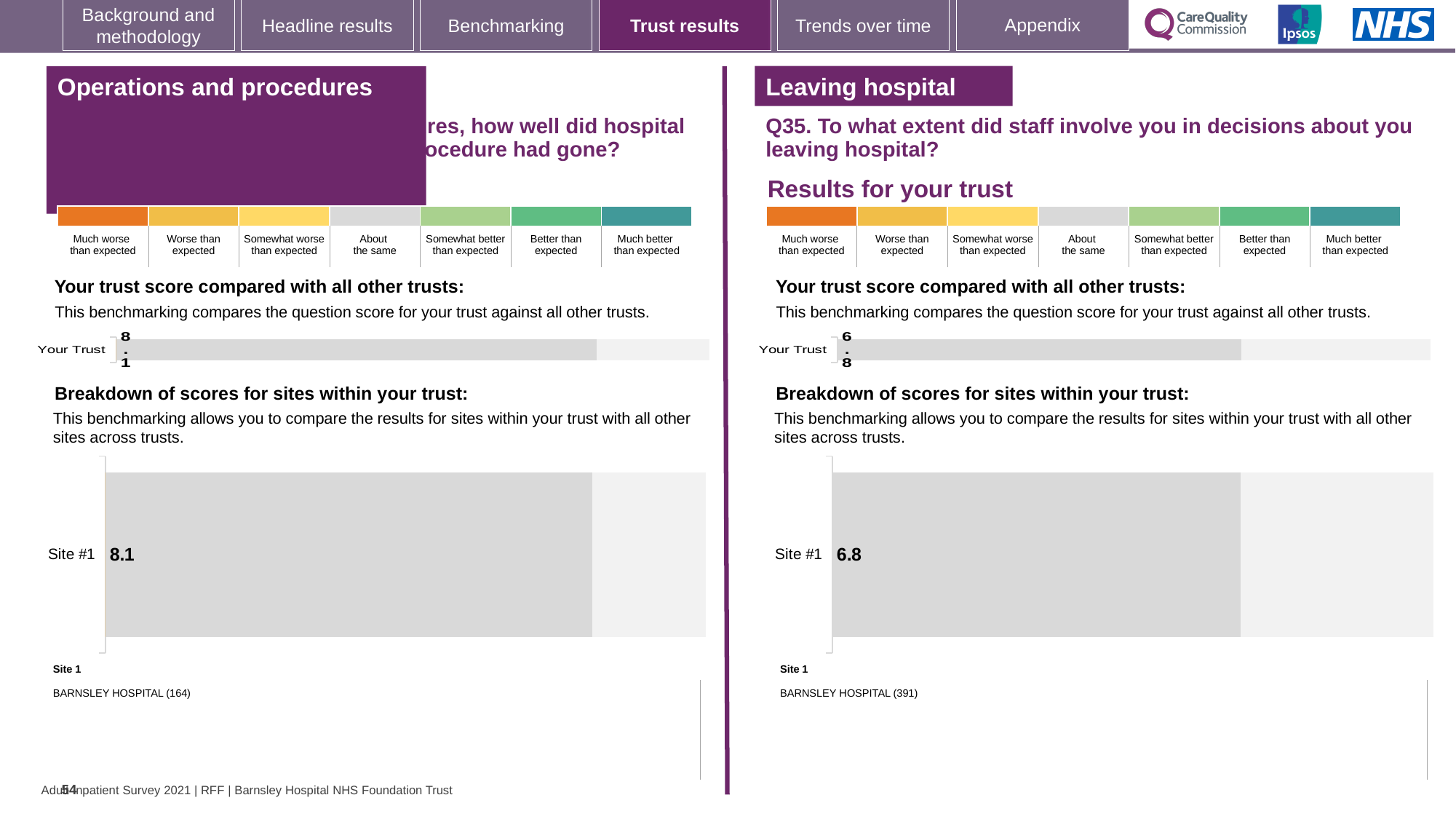
In the 'Breakdown of scores for sites within your trust' chart on the right (Leaving hospital), what is the score for Site #1? 6.8 What type of chart is used to show the Site #1 score in the Leaving hospital breakdown section? Bar chart On the 'Operations and procedures' section, what is the score shown for Your Trust in the 'Your trust score compared with all other trusts' chart? 8.1 Which is larger: the Site #1 score in the Operations and procedures breakdown chart or the Site #1 score in the Leaving hospital breakdown chart? Operations and procedures (8.1) What is the difference between the Site #1 score in the Operations and procedures breakdown chart and the Site #1 score in the Leaving hospital breakdown chart? 1.3 How many sites are plotted in the 'Breakdown of scores for sites within your trust' chart on the left (Operations and procedures)? 1 Is the Your Trust score in the Leaving hospital section greater or less than the Your Trust score in the Operations and procedures section? less Which site name is listed as Site 1 under the Leaving hospital breakdown chart? BARNSLEY HOSPITAL (391) In the 'Breakdown of scores for sites within your trust' chart on the left (Operations and procedures), what is the score for Site #1? 8.1 Which site name is listed as Site 1 under the Operations and procedures breakdown chart? BARNSLEY HOSPITAL (164) How many sites are plotted in the 'Breakdown of scores for sites within your trust' chart on the right (Leaving hospital)? 1 On the 'Leaving hospital' section, what is the score shown for Your Trust in the 'Your trust score compared with all other trusts' chart? 6.8